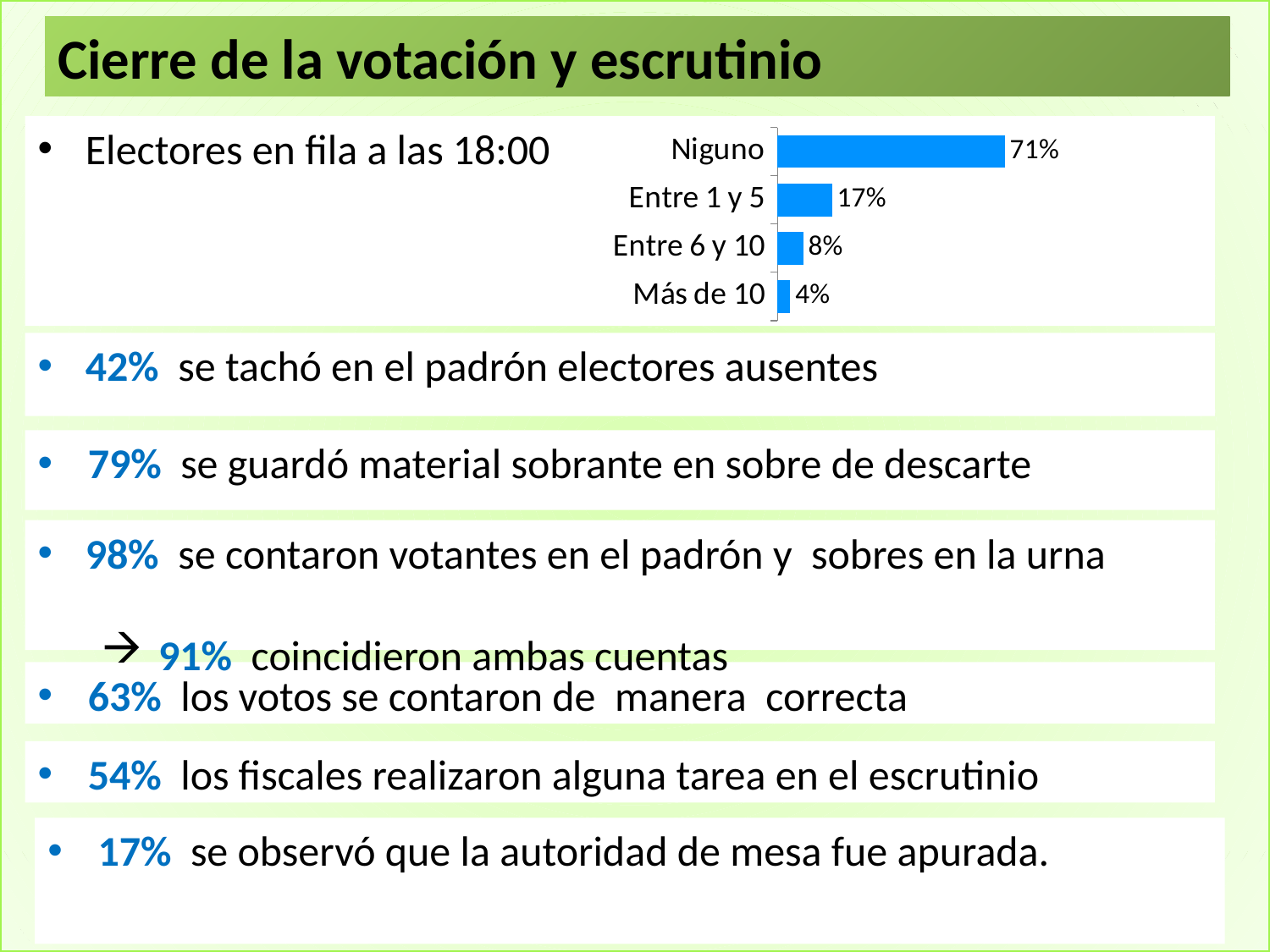
What value does the chart show for 'Entre 1 y 5'? 17% What percentage is shown for 'Más de 10'? 4% What value does the chart show for 'Entre 6 y 10'? 8% What kind of chart is shown on the slide? Bar chart What is the difference between the values for 'Niguno' and 'Entre 1 y 5'? 54% What colour are the bars in the chart? Blue Which category has the lowest value in the chart? Más de 10 What is the difference between the values for 'Entre 6 y 10' and 'Más de 10'? 4% Which category has the highest value in the chart? Niguno How many categories does the chart show? 4 Which is larger, the value for 'Entre 1 y 5' or the value for 'Entre 6 y 10'? Entre 1 y 5 What percentage is shown for the 'Niguno' category in the chart? 71%